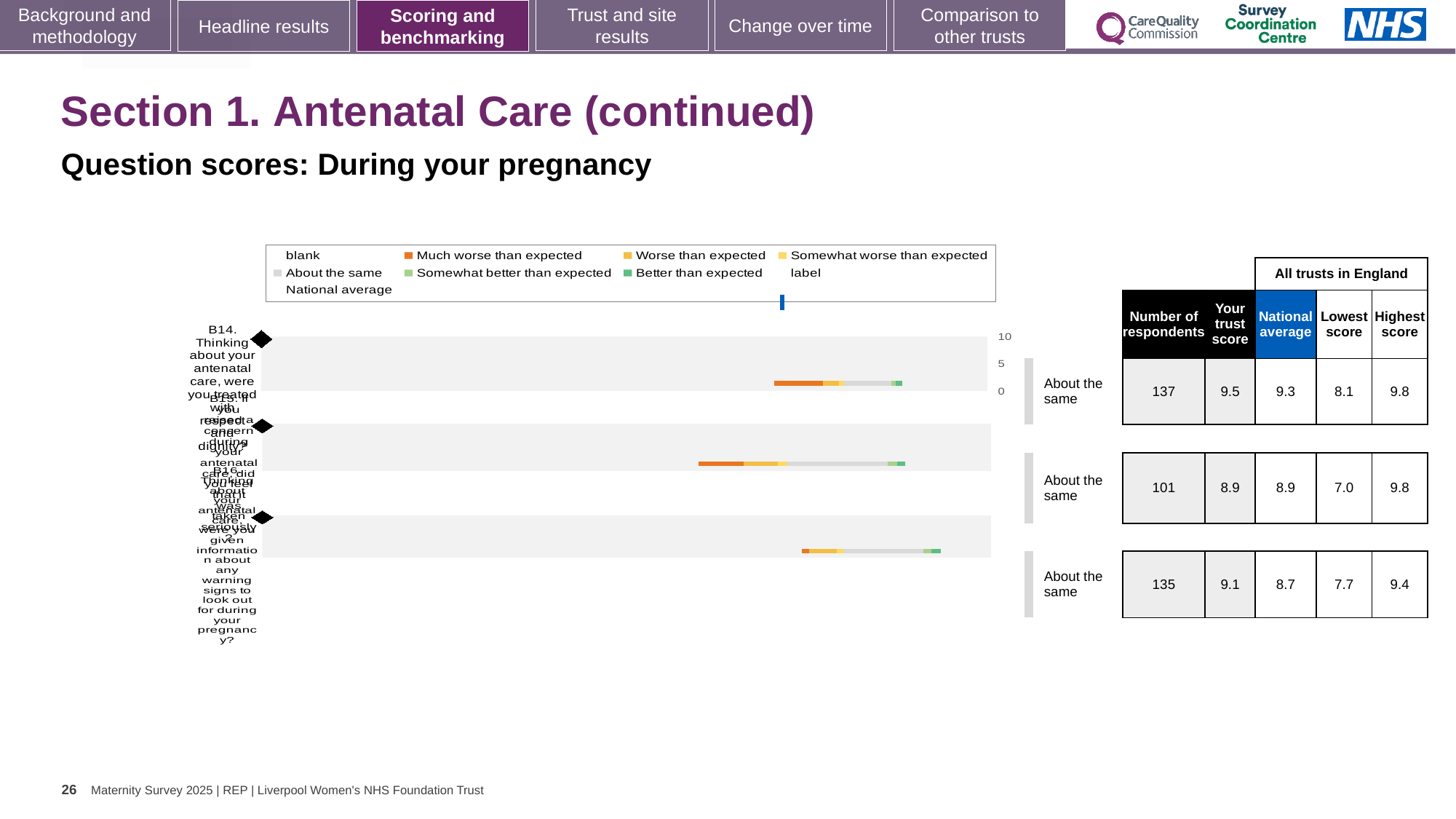
Which row in the table has the highest number of respondents? the first row (B14), 137 In the table beside the chart, what is the national average for the second row? 8.9 Which row in the table has the lowest 'Lowest score' value? the second row, 7.0 How many question bars are plotted in the chart? 3 In the table beside the chart, what is the trust score for the first row (B14, treated with respect and dignity)? 9.5 What is the highest value shown on the chart's axis? 10 In the table beside the chart, what is the number of respondents for the first row (B14, treated with respect and dignity)? 137 What is the difference between the trust score and the national average for the first row (B14)? 0.2 What kind of chart is shown on the slide? bar chart What benchmark category is shown next to each of the three bars? About the same For the third row (B16), is the trust score or the national average larger? the trust score (9.1) In the table beside the chart, what is the lowest score for the third row (B16, information about warning signs)? 7.7